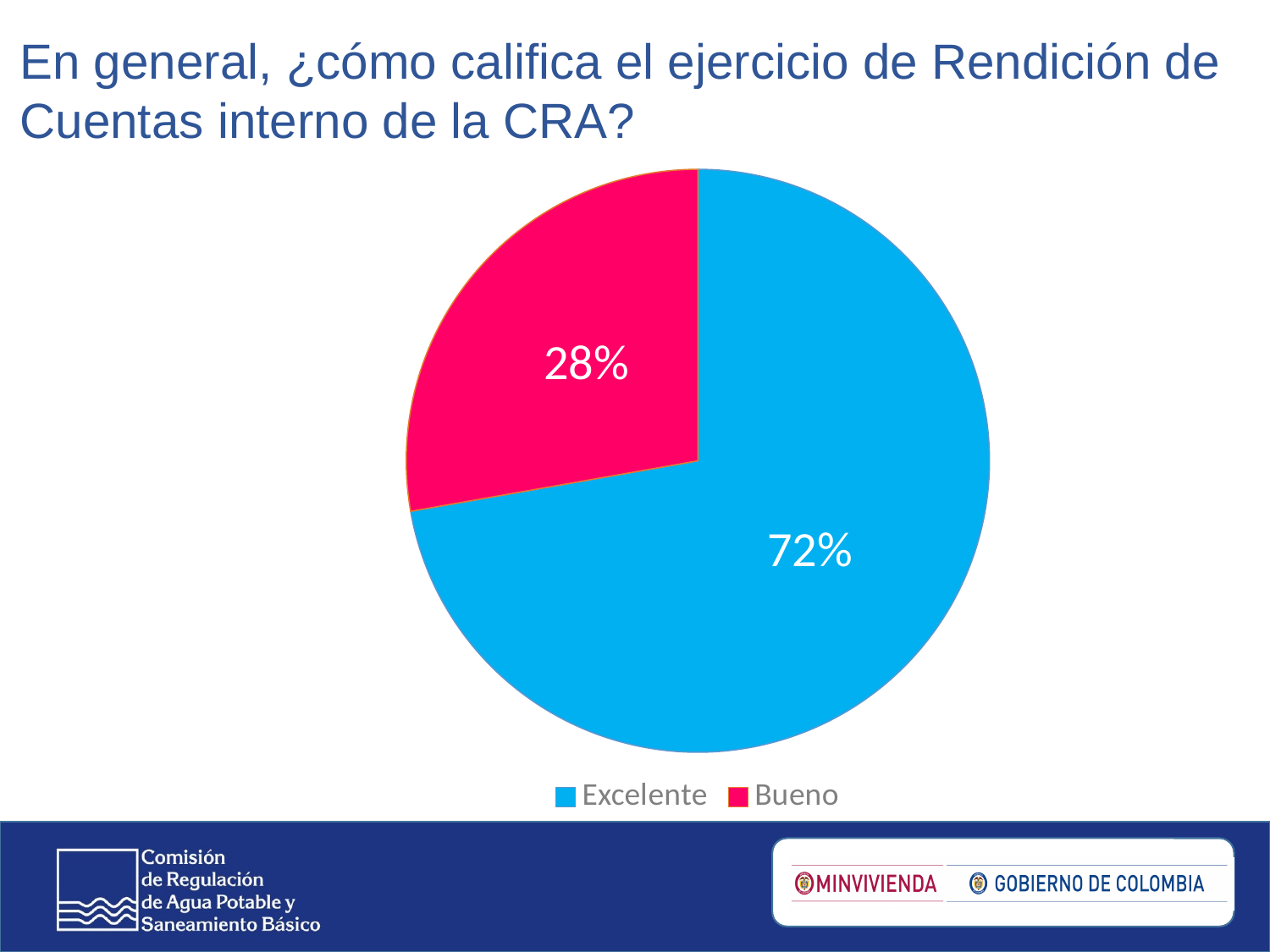
What colour is the Excelente slice? Blue How many entries does the legend list? 2 What share of the pie is labelled Excelente? 72% Which category has the smallest slice of the pie? Bueno Which is larger, the Excelente slice or the Bueno slice? Excelente What colour is the Bueno slice? Pink What kind of chart is shown on the slide? Pie chart What is the difference in percentage points between the Excelente and Bueno slices? 44 How many slices does the pie chart have? 2 Is the Excelente share greater or less than 50%? greater What share of the pie is labelled Bueno? 28% Which category has the largest slice of the pie? Excelente